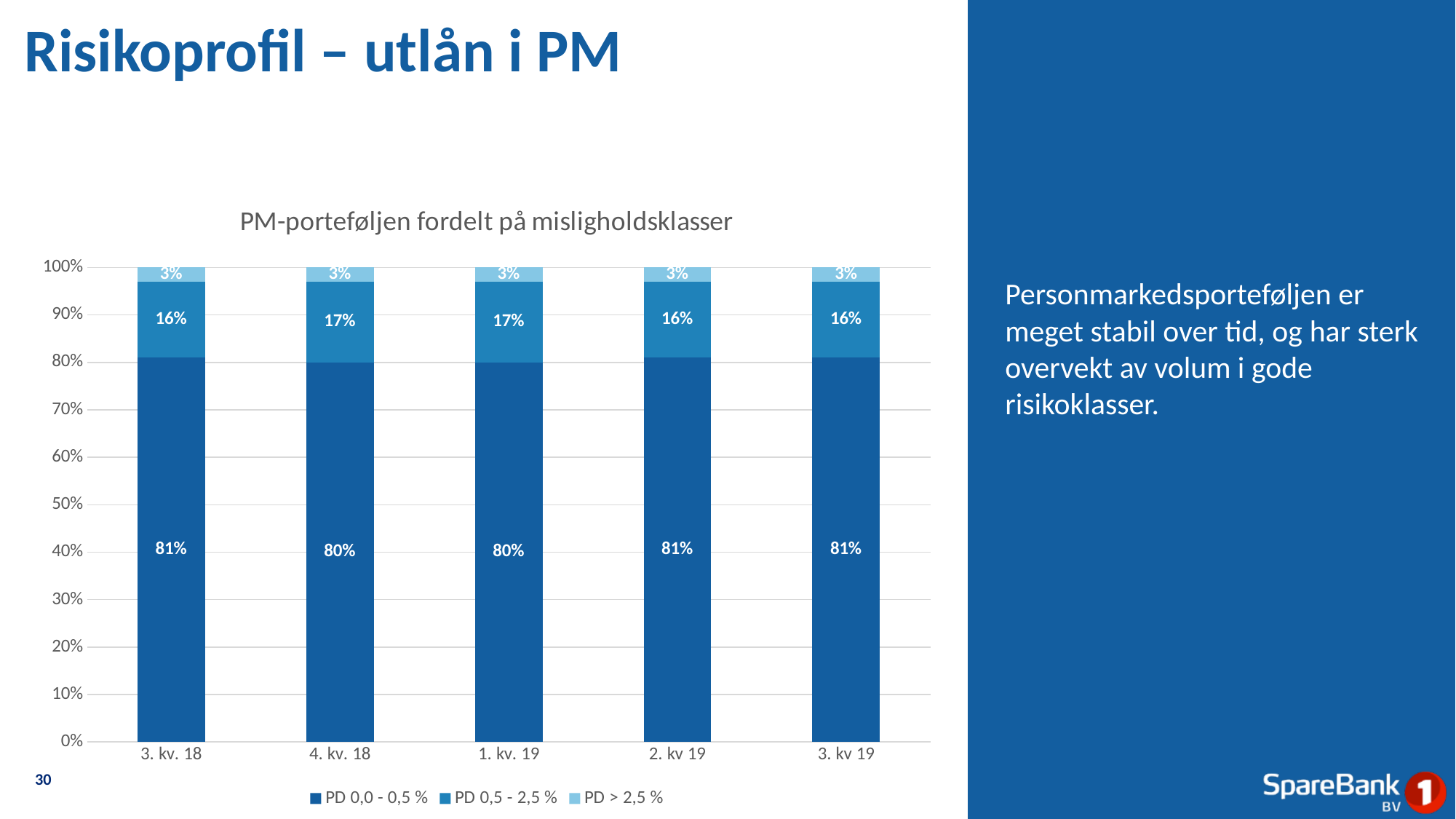
What is the value for PD 0,5 - 2,5 % in 1. kv. 19? 17% What is the total of the stacked bar for 3. kv. 18? 100% What is the difference between the PD 0,0 - 0,5 % value and the PD 0,5 - 2,5 % value in 2. kv 19? 65% What is the title of the chart? PM-porteføljen fordelt på misligholdsklasser How many quarters are shown on the x axis? 5 How many series does the legend list? 3 What is the value for PD 0,0 - 0,5 % in 4. kv. 18? 80% What is the value for PD 0,0 - 0,5 % in 3. kv. 18? 81% What type of chart is shown on the slide? Stacked bar chart Which is larger in 4. kv. 18: the PD 0,5 - 2,5 % value or the PD > 2,5 % value? PD 0,5 - 2,5 % What is the value for PD > 2,5 % in 3. kv 19? 3% Is the value for PD 0,0 - 0,5 % in 1. kv. 19 greater or less than 70%? greater